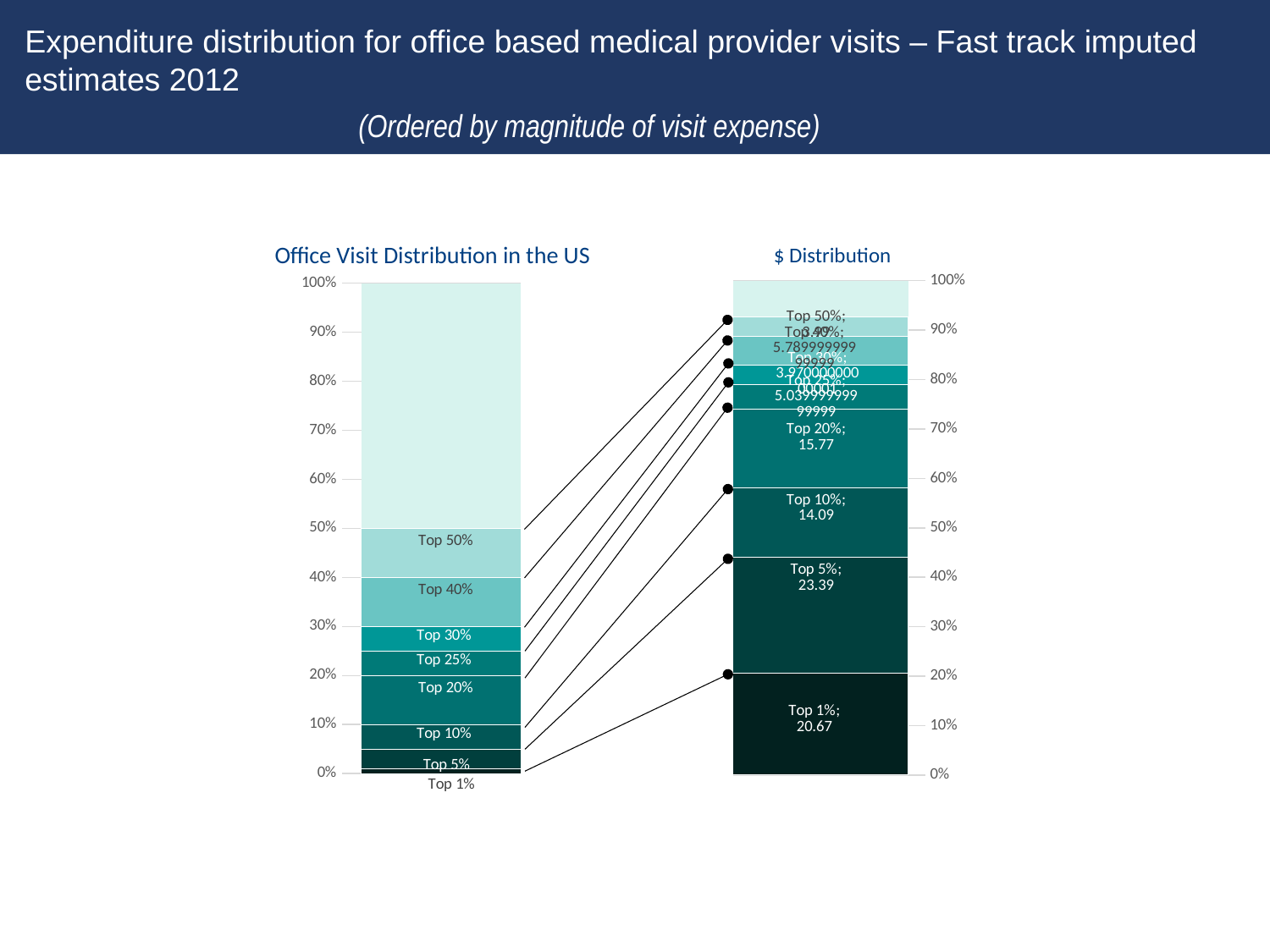
In the $ Distribution chart, is the top edge of the Top 1% segment greater or less than 30%? less In the $ Distribution chart, what is the combined value of the Top 1% and Top 5% segments? 44.06 In the $ Distribution chart, what is the value for the Top 5% segment? 23.39 What kind of chart is used on this slide? Stacked bar chart In the $ Distribution chart, which segment has the largest value? Top 5% In the $ Distribution chart, which is larger, the Top 10% value or the Top 20% value? Top 20% What is the title of the chart on the left side of the slide? Office Visit Distribution in the US In the $ Distribution chart, what is the difference between the Top 20% value and the Top 10% value? 1.68 In the $ Distribution chart, what is the value for the Top 10% segment? 14.09 In the $ Distribution chart, what is the value for the Top 20% segment? 15.77 In the $ Distribution chart, what is the difference between the Top 5% value and the Top 1% value? 2.72 In the $ Distribution chart, what is the value for the Top 1% segment? 20.67